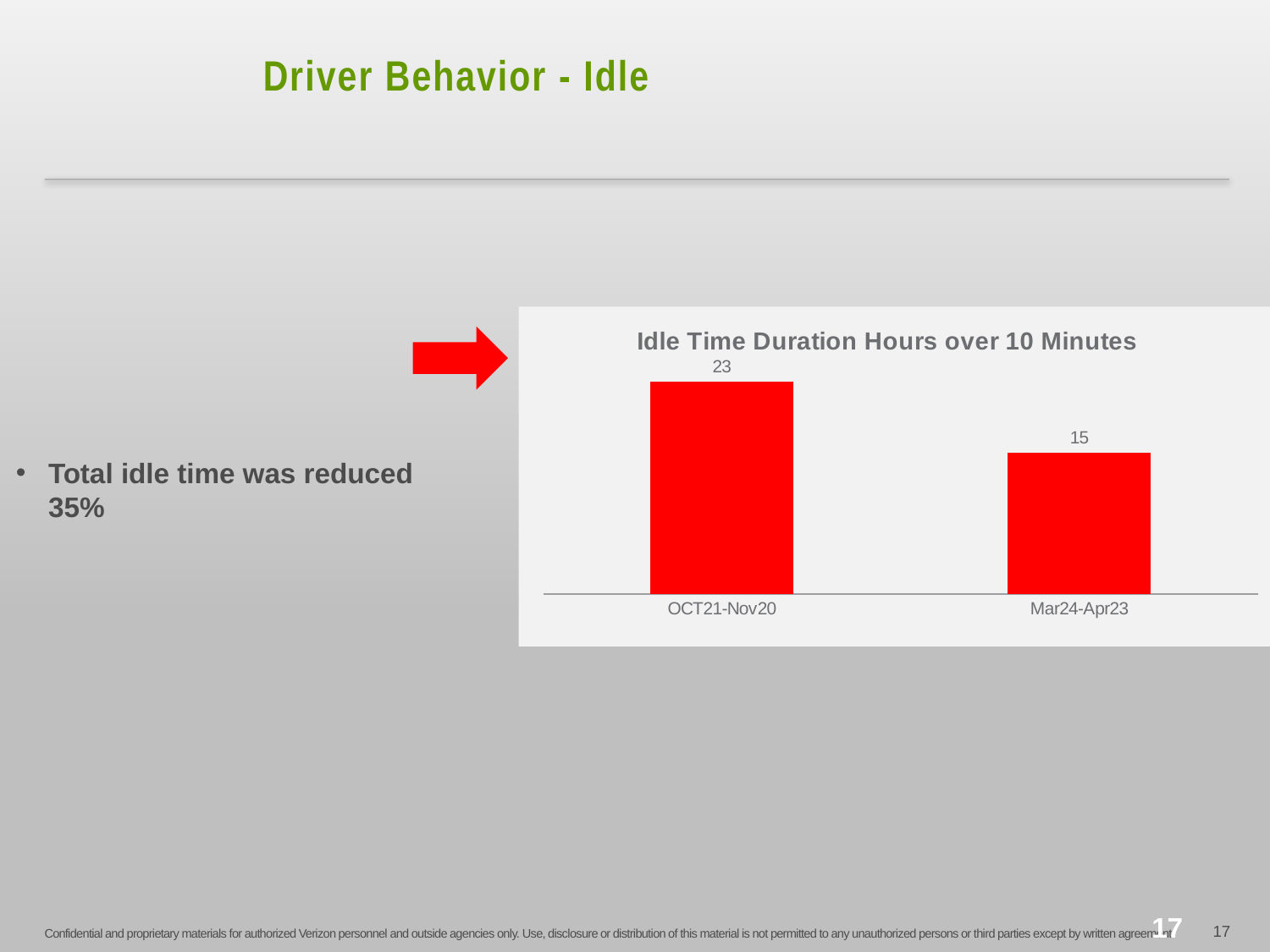
What is the value for OCT21-Nov20 in the Idle Time Duration Hours over 10 Minutes chart? 23 Which period has the highest idle time duration hours in the chart? OCT21-Nov20 How many categories are shown in the Idle Time Duration Hours over 10 Minutes chart? 2 What is the value for Mar24-Apr23 in the Idle Time Duration Hours over 10 Minutes chart? 15 What is the title of the chart on the slide? Idle Time Duration Hours over 10 Minutes Do the values rise or fall from OCT21-Nov20 to Mar24-Apr23 in the chart? Fall Which is larger in the chart: the value for OCT21-Nov20 or the value for Mar24-Apr23? OCT21-Nov20 What kind of chart is shown on the slide? Bar chart What is the difference between the OCT21-Nov20 and Mar24-Apr23 values in the chart? 8 Which period has the lowest idle time duration hours in the chart? Mar24-Apr23 What colour are the bars in the chart? Red